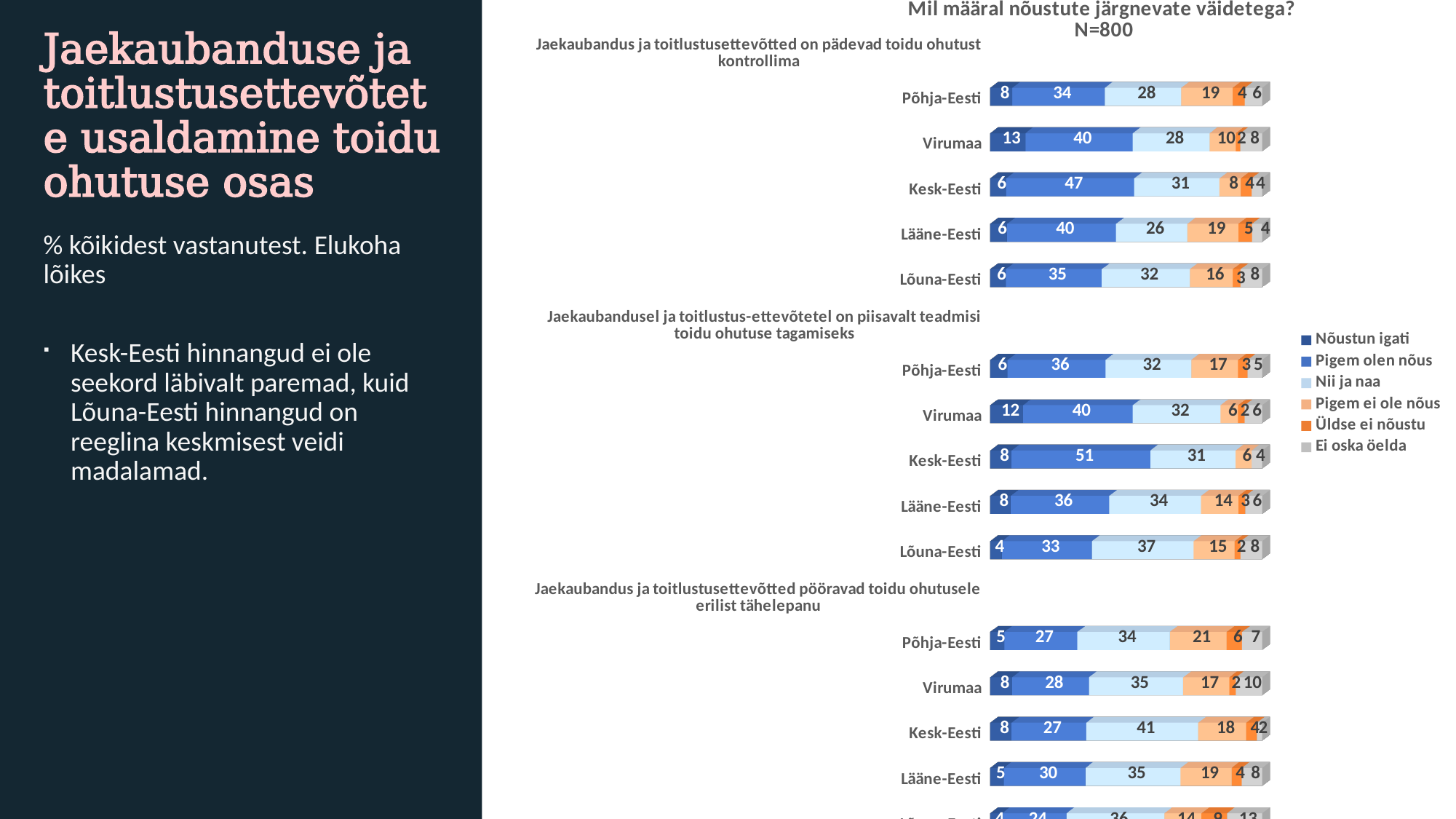
For the statement 'Jaekaubandusel ja toitlustus-ettevõtetel on piisavalt teadmisi toidu ohutuse tagamiseks', what is the difference between the 'Pigem olen nõus' values for Kesk-Eesti and Põhja-Eesti? 15 For the statement 'Jaekaubandus ja toitlustusettevõtted pööravad toidu ohutusele erilist tähelepanu', what is the difference between the 'Pigem ei ole nõus' values for Põhja-Eesti and Virumaa? 4 What kind of chart is shown on the slide? Stacked bar chart How many series does the legend list? 6 For the statement 'Jaekaubandusel ja toitlustus-ettevõtetel on piisavalt teadmisi toidu ohutuse tagamiseks', what is the 'Nii ja naa' value for Lõuna-Eesti? 37 For the statement 'Jaekaubandusel ja toitlustus-ettevõtetel on piisavalt teadmisi toidu ohutuse tagamiseks', which region has the lowest 'Nõustun igati' value? Lõuna-Eesti For the statement 'Jaekaubandus ja toitlustusettevõtted on pädevad toidu ohutust kontrollima', what is the 'Pigem olen nõus' value for Kesk-Eesti? 47 For the statement 'Jaekaubandus ja toitlustusettevõtted on pädevad toidu ohutust kontrollima', which region has the highest 'Nõustun igati' value? Virumaa What sample size (N) is shown in the chart title? N=800 For the statement 'Jaekaubandus ja toitlustusettevõtted on pädevad toidu ohutust kontrollima', which is larger: the 'Pigem olen nõus' value for Virumaa or for Lõuna-Eesti? Virumaa How many regions are listed under each statement in the chart? 5 For the statement 'Jaekaubandus ja toitlustusettevõtted pööravad toidu ohutusele erilist tähelepanu', what is the 'Nii ja naa' value for Kesk-Eesti? 41